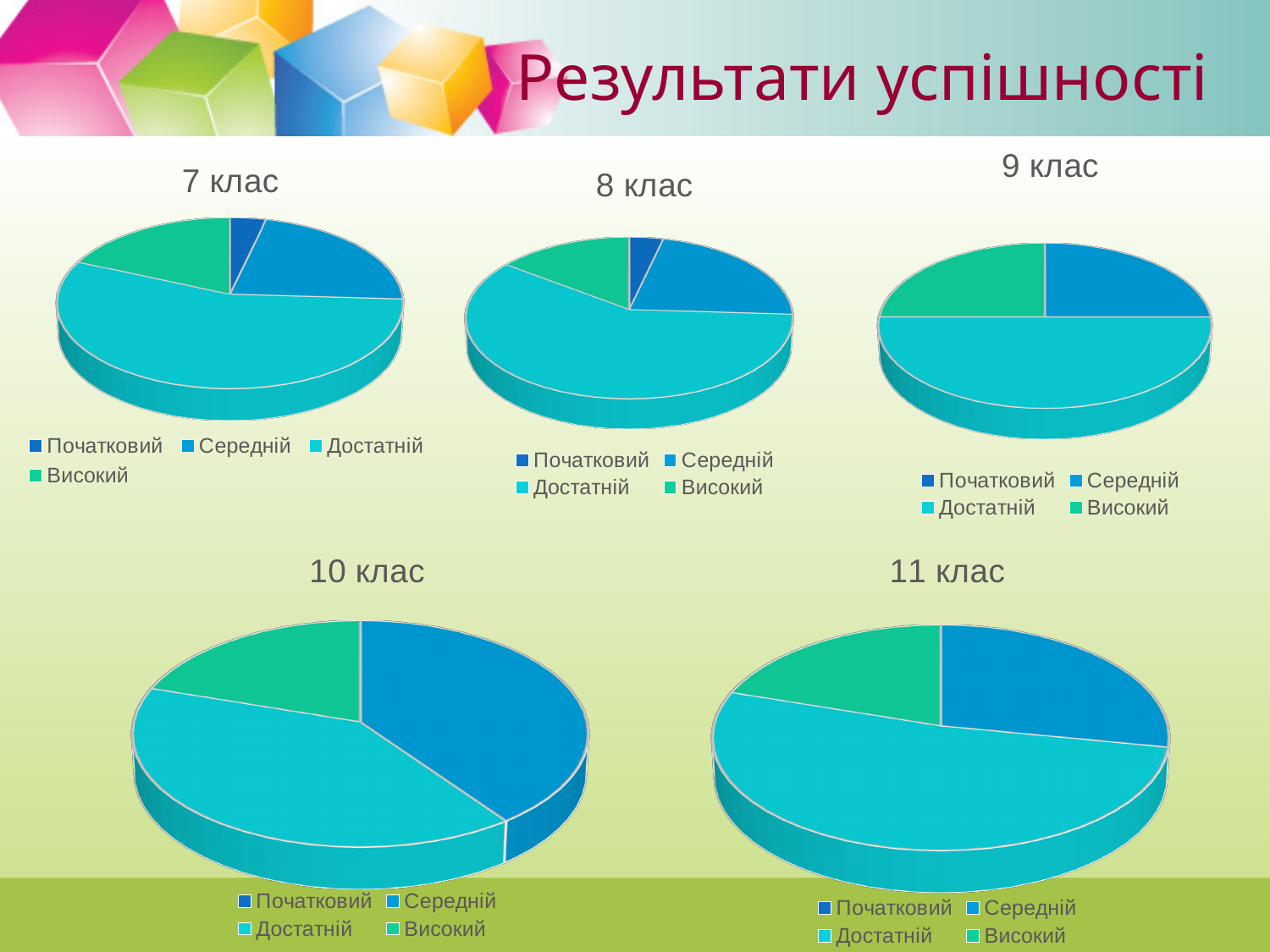
How many pie charts are shown on the slide? 5 What kind of chart is used for the 7 клас chart? pie chart How many entries does the legend of the 8 клас chart list? 4 In the 8 клас chart, which category has the smallest slice? Початковий In the 11 клас chart, which category has the largest slice? Достатній In the 7 клас chart, which category has the smallest slice? Початковий In the 7 клас chart, which category has the largest slice? Достатній Which legend entry is shown in the lightest blue (cyan) colour in the 10 клас chart? Достатній In the 10 клас chart, which slice is larger: Середній or Високий? Середній What is the title of the slide? Результати успішності In the 7 клас chart, which slice is larger: Середній or Високий? Середній In the 9 клас chart, which category has the largest slice? Достатній